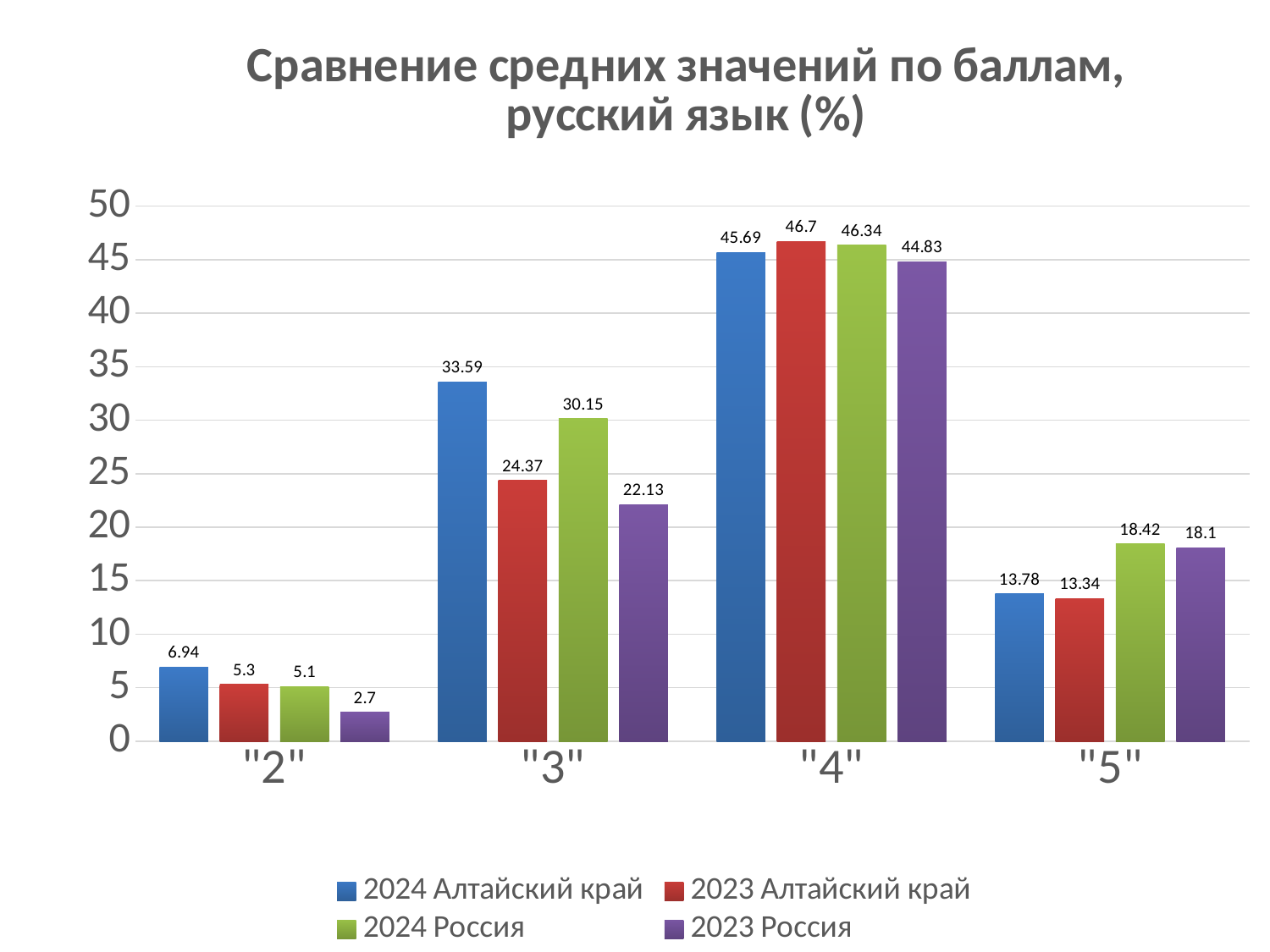
What is the title of the chart? Сравнение средних значений по баллам, русский язык (%) Is the value for "2024 Россия" in category "3" greater or less than 25? greater What is the value for "2024 Алтайский край" in category "3"? 33.59 Which series has the highest value in category "4"? 2023 Алтайский край Which series has the lowest value in category "3"? 2023 Россия What is the value for "2024 Россия" in category "5"? 18.42 What is the value for "2023 Россия" in category "2"? 2.7 How many series does the legend list? 4 How many categories are shown on the x axis? 4 What is the difference between "2024 Алтайский край" and "2023 Алтайский край" in category "3"? 9.22 Which is larger in category "5": "2024 Россия" or "2023 Алтайский край"? 2024 Россия What kind of chart is shown on the slide? bar chart